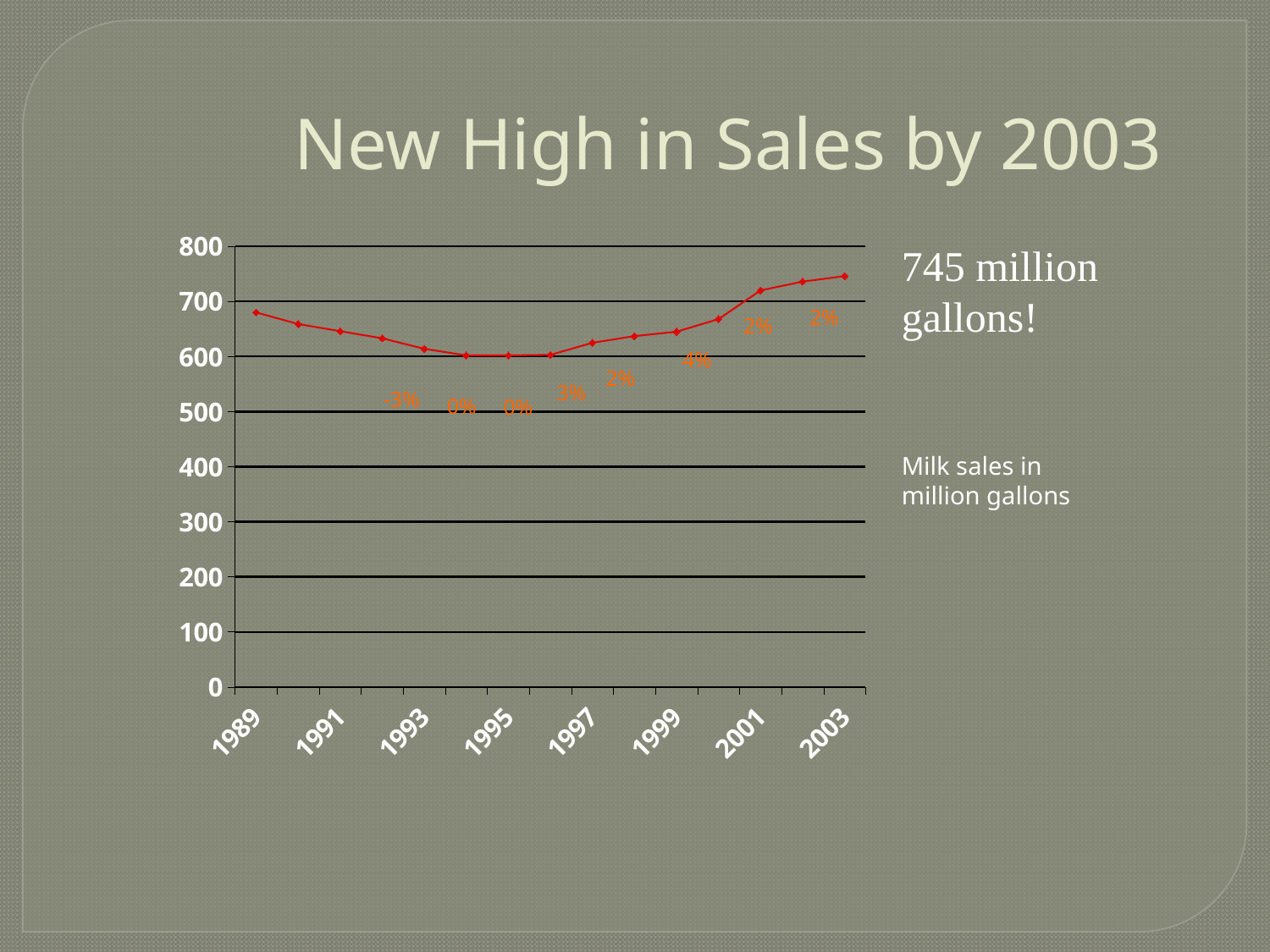
In what units are milk sales plotted on the chart? million gallons Which year has higher milk sales, 1989 or 2003? 2003 What is the title of the slide's chart? New High in Sales by 2003 What are the milk sales in 2003 according to the slide? 745 million gallons Is the value for 1995 greater or less than 700? less What kind of chart is shown on the slide? line chart Do milk sales rise or fall from 1996 to 2003? rise Do milk sales rise or fall from 1989 to 1994? fall Which year has the highest milk sales on the chart? 2003 Is the value for 1989 greater or less than 600? greater Which year has higher milk sales, 1989 or 1995? 1989 Is the value for 2003 greater or less than 700? greater